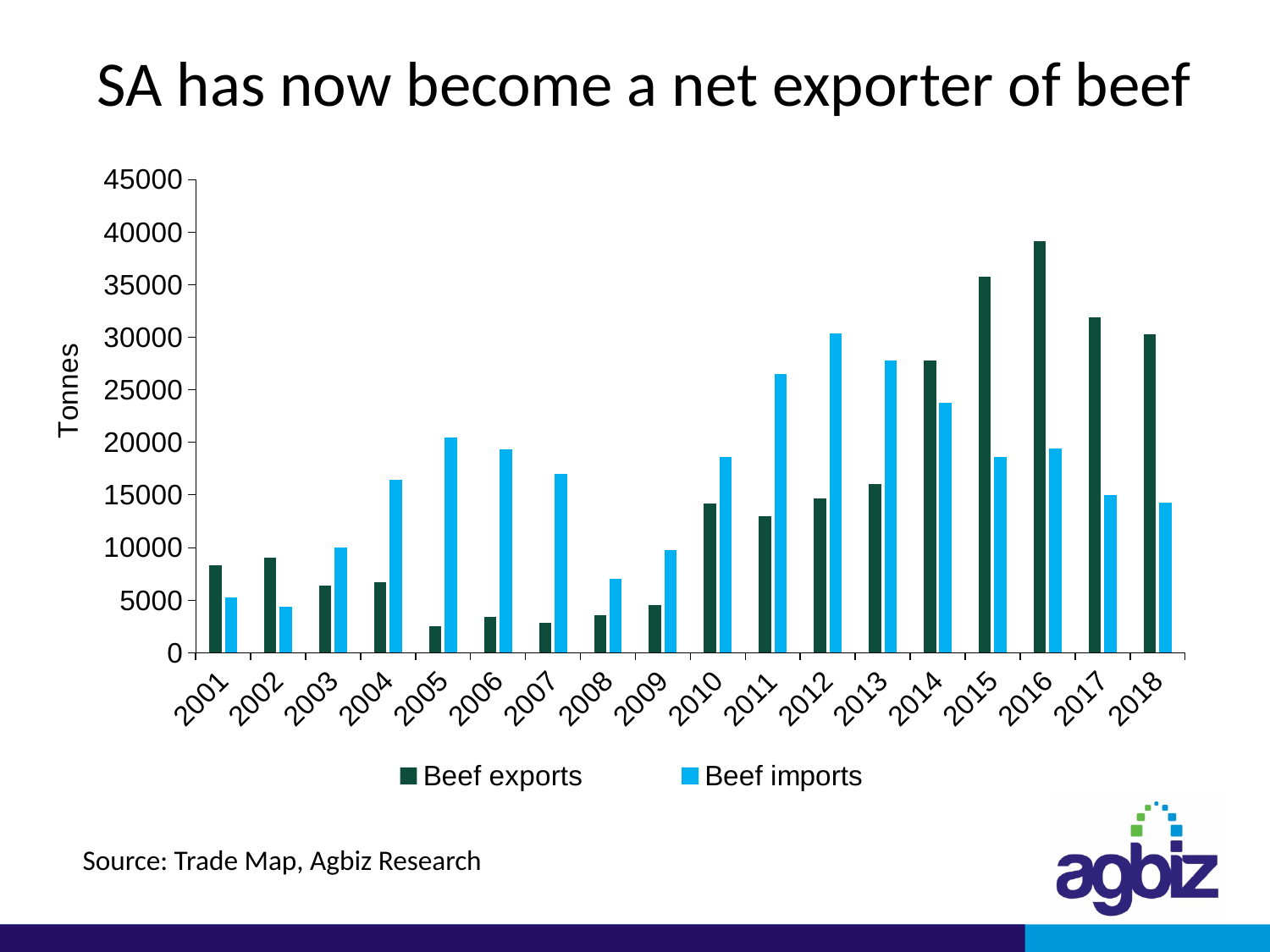
In which year were beef imports highest? 2012 Is the value for beef exports in 2016 greater or less than 35000? greater How many series does the legend list? 2 In 2012, which was larger: beef exports or beef imports? Beef imports Is the value for beef imports in 2018 greater or less than 15000? less In which year were beef imports lowest? 2002 What kind of chart is shown on the slide? Bar chart In which year were beef exports lowest? 2005 How many years are shown on the x axis? 18 In which year were beef exports highest? 2016 In 2017, which was larger: beef exports or beef imports? Beef exports What is the title of the slide? SA has now become a net exporter of beef